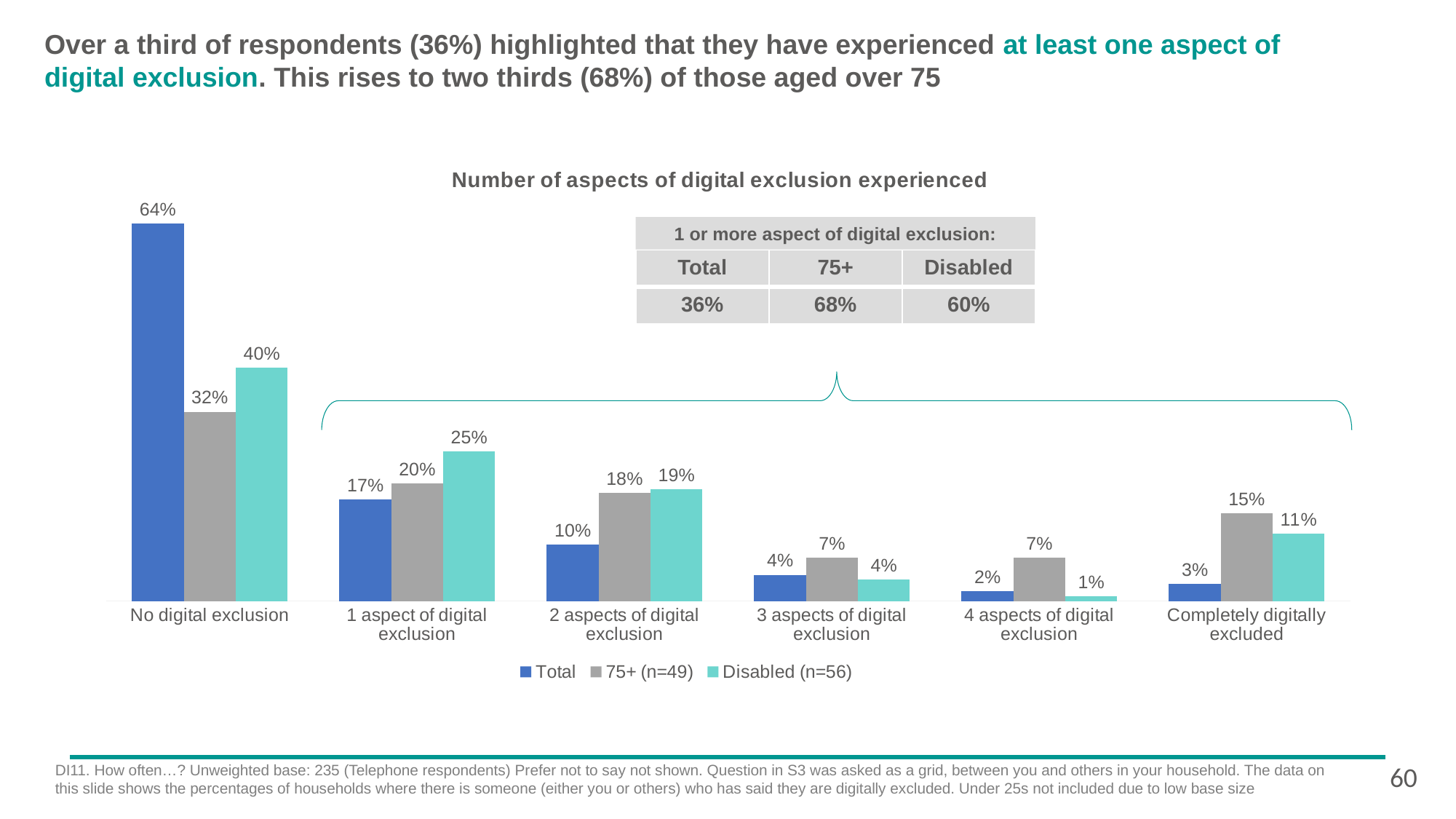
What is the difference between the Disabled (n=56) and Total values for 'No digital exclusion'? 24% What kind of chart is shown on the slide? Bar chart Which category has the lowest Disabled (n=56) value? 4 aspects of digital exclusion What is the title of the chart? Number of aspects of digital exclusion experienced What is the value for the 75+ (n=49) series for '1 aspect of digital exclusion'? 20% For '2 aspects of digital exclusion', which is larger: the Total value or the 75+ (n=49) value? 75+ (n=49) What is the difference between the 75+ (n=49) and Total values for 'Completely digitally excluded'? 12% What is the Disabled (n=56) value for 'Completely digitally excluded'? 11% What is the Total value for 'No digital exclusion'? 64% How many categories are shown on the x axis? 6 Which category has the highest Total value? No digital exclusion How many series does the legend list? 3